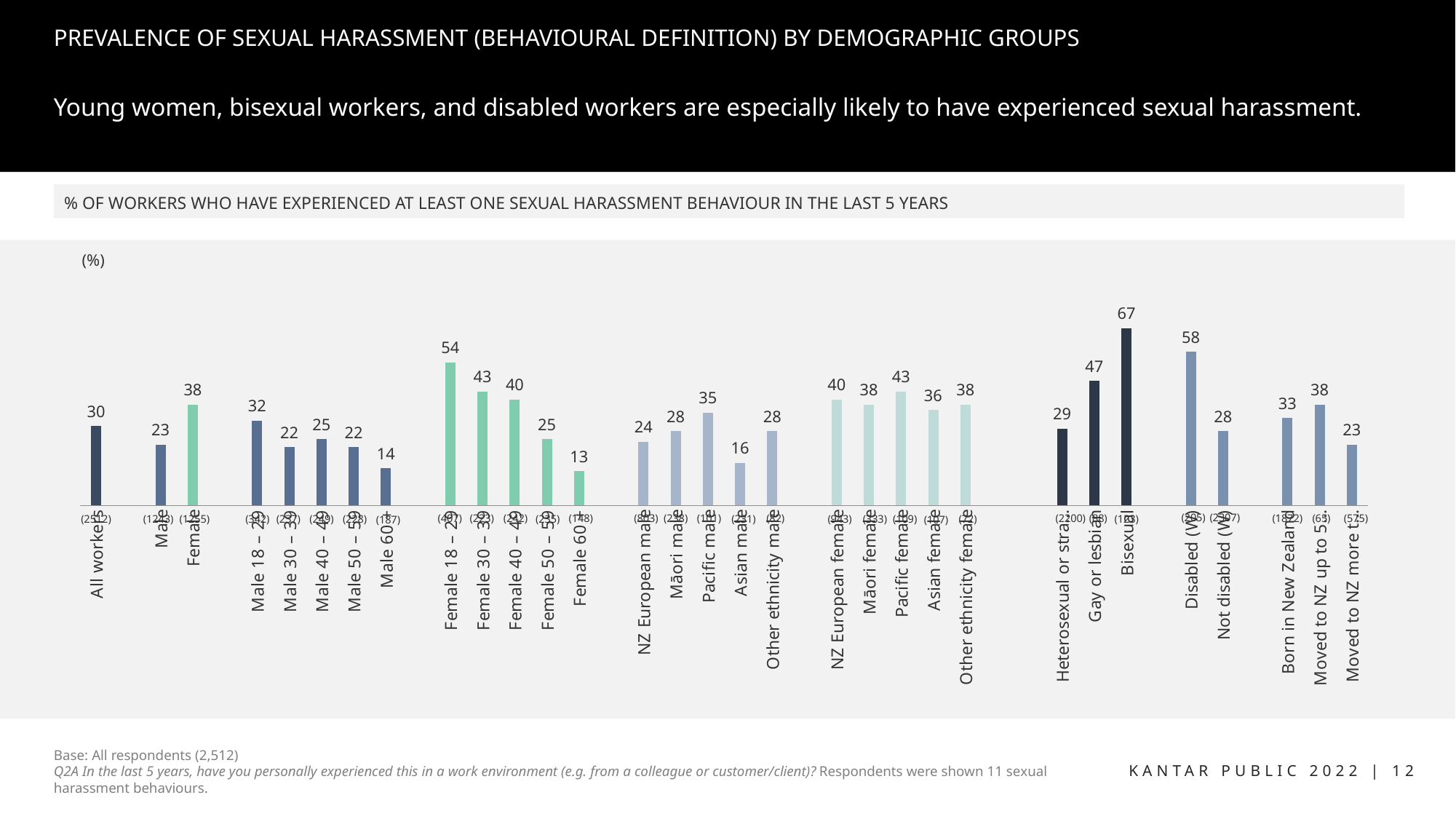
What is the difference between the values for Female and Male? 15 What is the value shown for Female 18 – 29? 54 What type of chart is shown on the slide? Bar chart What is the difference between the values for Disabled and Not disabled workers? 30 What is the value shown for Bisexual workers? 67 Which has a higher value, Pacific male or Asian male? Pacific male Do the values for the male age groups rise or fall from Male 18 – 29 to Male 60+? Fall Which demographic group has the lowest value on the chart? Female 60+ Which has a higher value, Born in New Zealand or Moved to NZ up to 5 years? Moved to NZ up to 5 years Which demographic group has the highest value on the chart? Bisexual What is the value shown for Gay or lesbian workers? 47 What percentage of all workers have experienced at least one sexual harassment behaviour in the last 5 years? 30